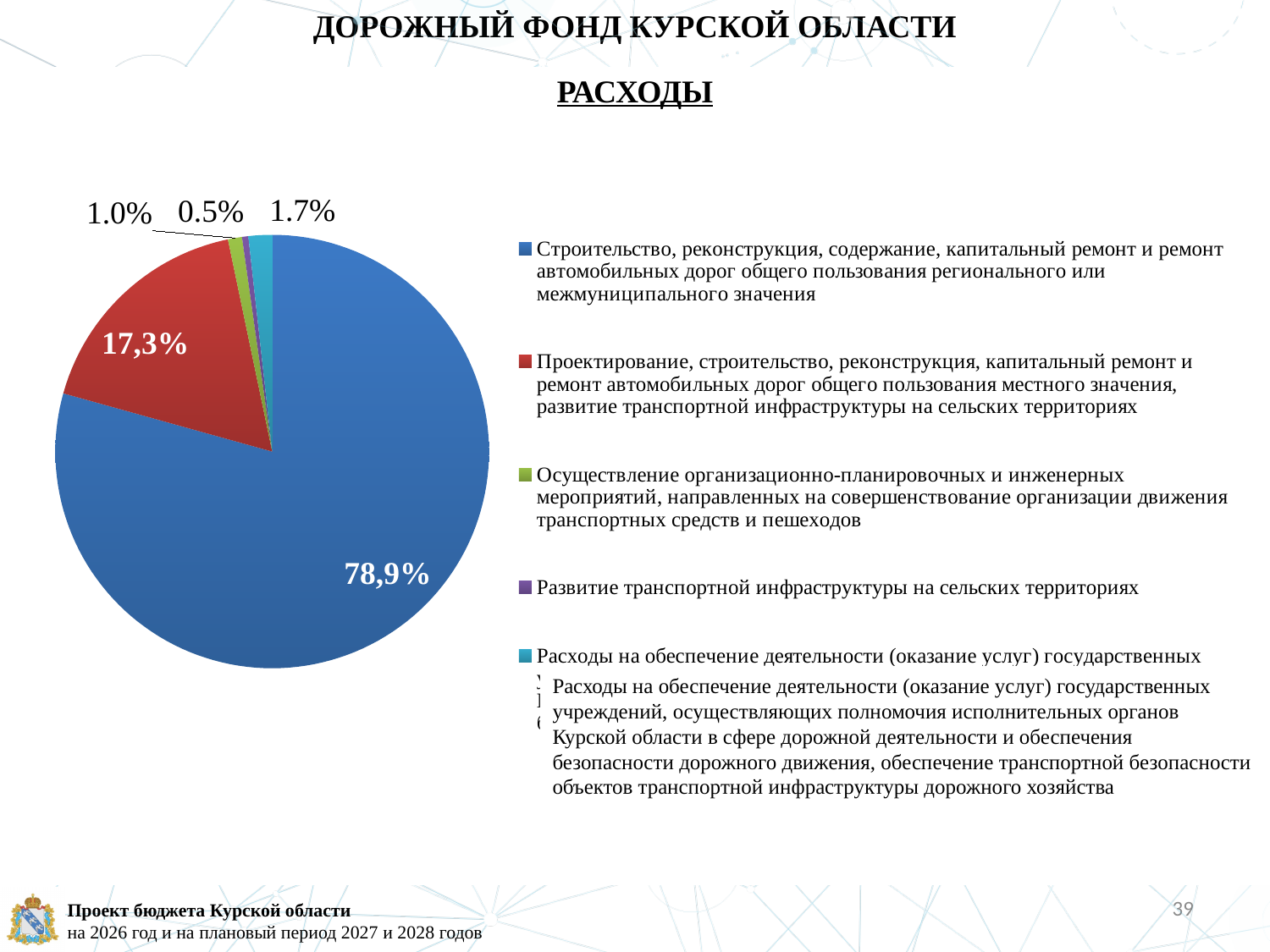
Which category has the smallest slice of the pie? Развитие транспортной инфраструктуры на сельских территориях What colour is the slice representing 78,9% of the pie? blue What kind of chart is shown on the slide? pie chart How many slices does the pie chart have? 5 What share of the pie is labelled for 'Проектирование, строительство, реконструкция, капитальный ремонт и ремонт автомобильных дорог общего пользования местного значения, развитие транспортной инфраструктуры на сельских территориях'? 17,3% Which is larger: the slice labelled 1.7% or the slice labelled 1.0%? 1.7% What share of the pie is labelled for 'Осуществление организационно-планировочных и инженерных мероприятий, направленных на совершенствование организации движения транспортных средств и пешеходов'? 1.0% How many entries does the legend of the pie chart list? 5 What share of the pie is labelled for 'Развитие транспортной инфраструктуры на сельских территориях'? 0.5% What is the difference in percentage points between the largest slice (78,9%) and the second largest slice (17,3%)? 61,6 Which category has the largest slice of the pie? Строительство, реконструкция, содержание, капитальный ремонт и ремонт автомобильных дорог общего пользования регионального или межмуниципального значения